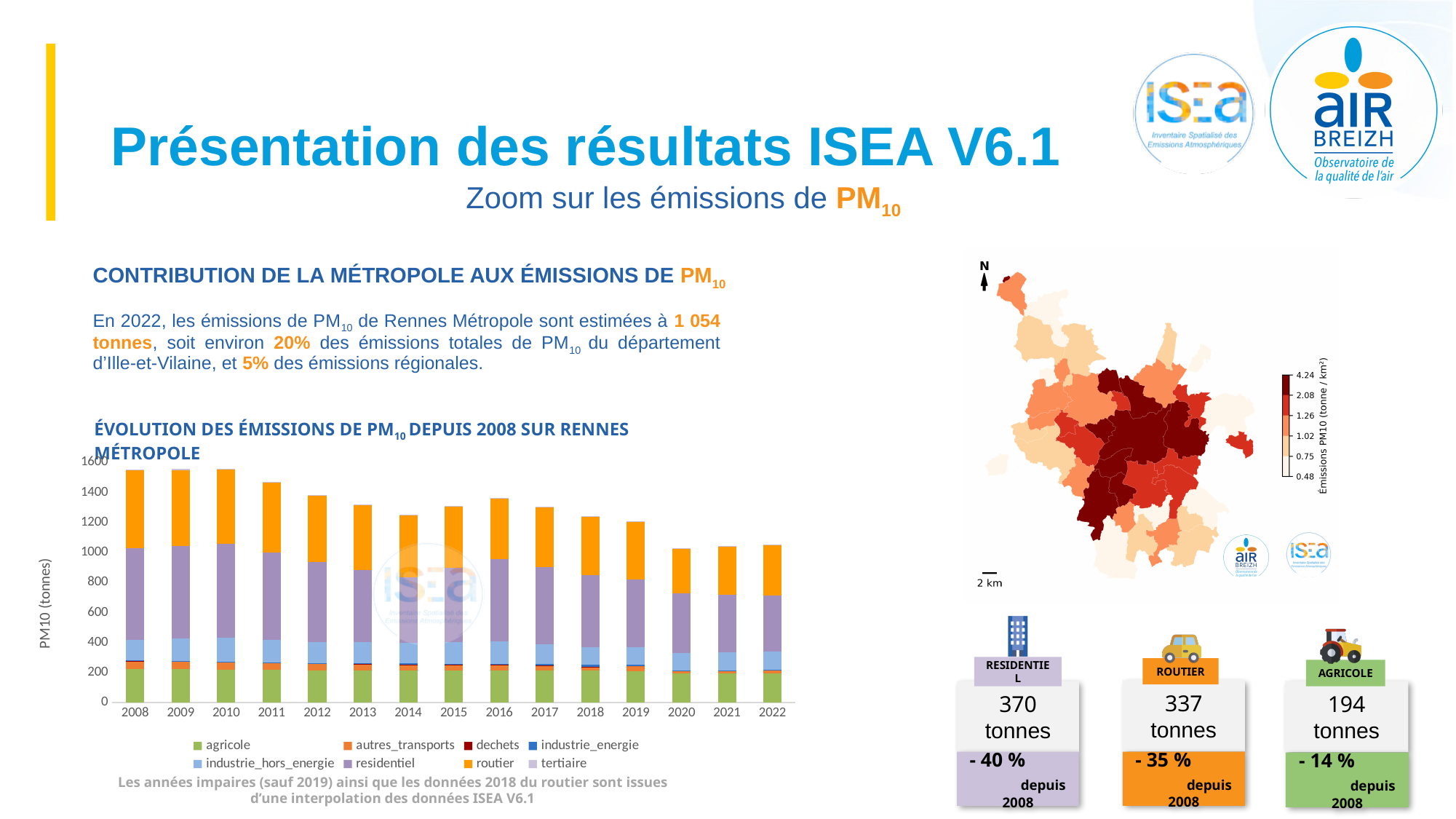
In the PM10 emissions evolution chart, is the total for 2016 greater or less than 1200 tonnes? greater In the PM10 emissions evolution chart, is the total for 2022 greater or less than 1200 tonnes? less What is the label of the y axis of the PM10 emissions evolution chart? PM10 (tonnes) What kind of chart is used to show the evolution of PM10 emissions since 2008 on Rennes Métropole? Stacked bar chart How many series does the legend of the PM10 emissions evolution chart list? 8 In the PM10 emissions evolution chart, which year has the larger total, 2016 or 2019? 2016 How many years are shown on the x axis of the PM10 emissions evolution chart? 15 In the PM10 emissions evolution chart, which year has the larger total, 2008 or 2020? 2008 In the PM10 emissions evolution chart, is the total for 2008 greater or less than 1400 tonnes? greater Which colour represents the 'routier' series in the PM10 emissions evolution chart? Orange Overall, do total PM10 emissions in the evolution chart rise or fall from 2008 to 2022? fall